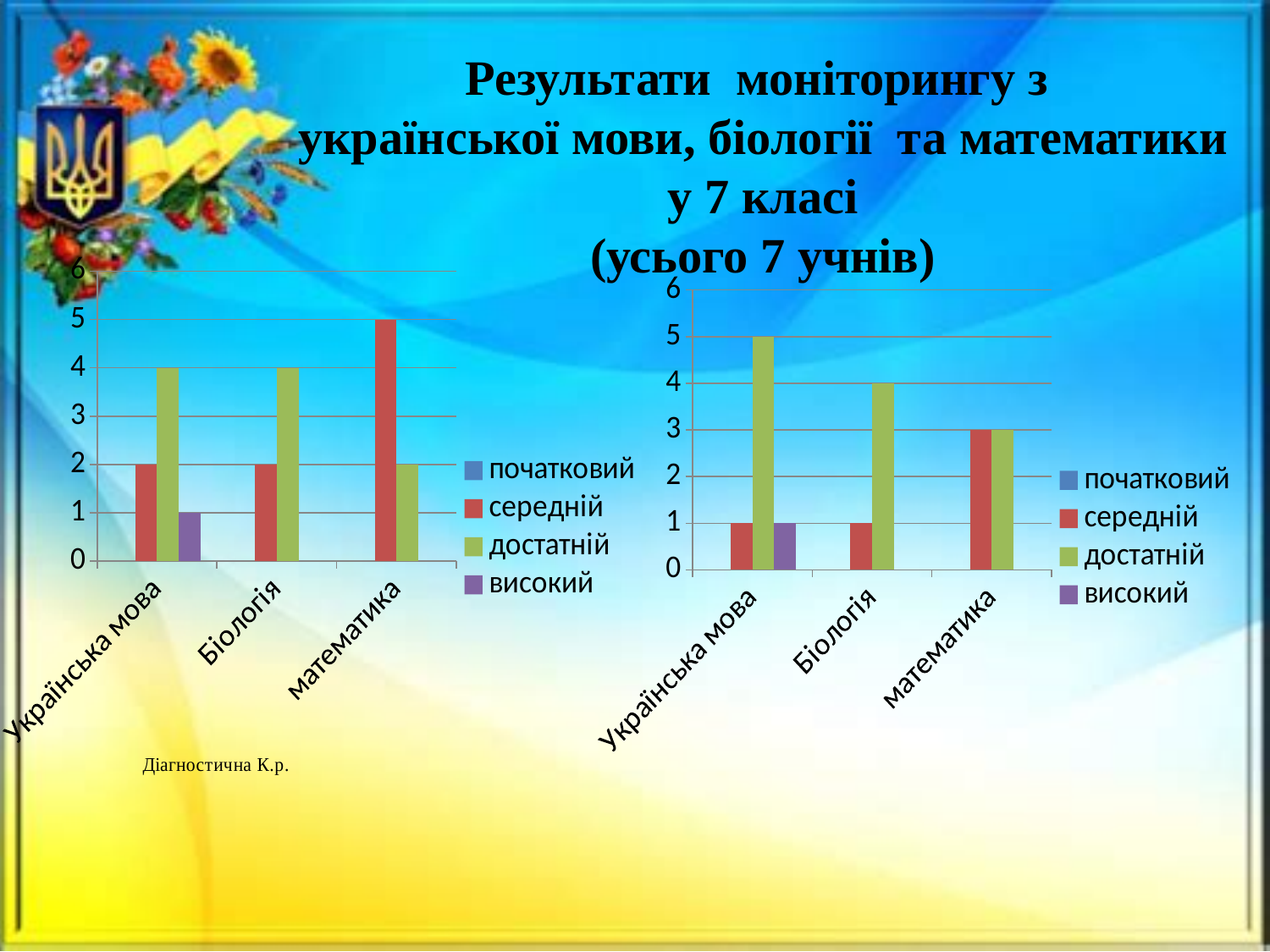
In the right chart, which category has the lowest достатній value? математика In the left chart, what is the value of середній for математика? 5 In the right chart, which is larger for Біологія: середній or достатній? достатній In the left chart, what is the difference between достатній and середній for Українська мова? 2 In the right chart, what is the value of достатній for Українська мова? 5 How many categories are shown on the x axis of the right chart? 3 In the left chart, what is the value of високий for Українська мова? 1 In the left chart, what is the value of достатній for Біологія? 4 How many series does the legend of the left chart list? 4 What type of chart is the right chart? bar chart In the right chart, what is the value of середній for математика? 3 In the left chart, which category has the highest середній value? математика